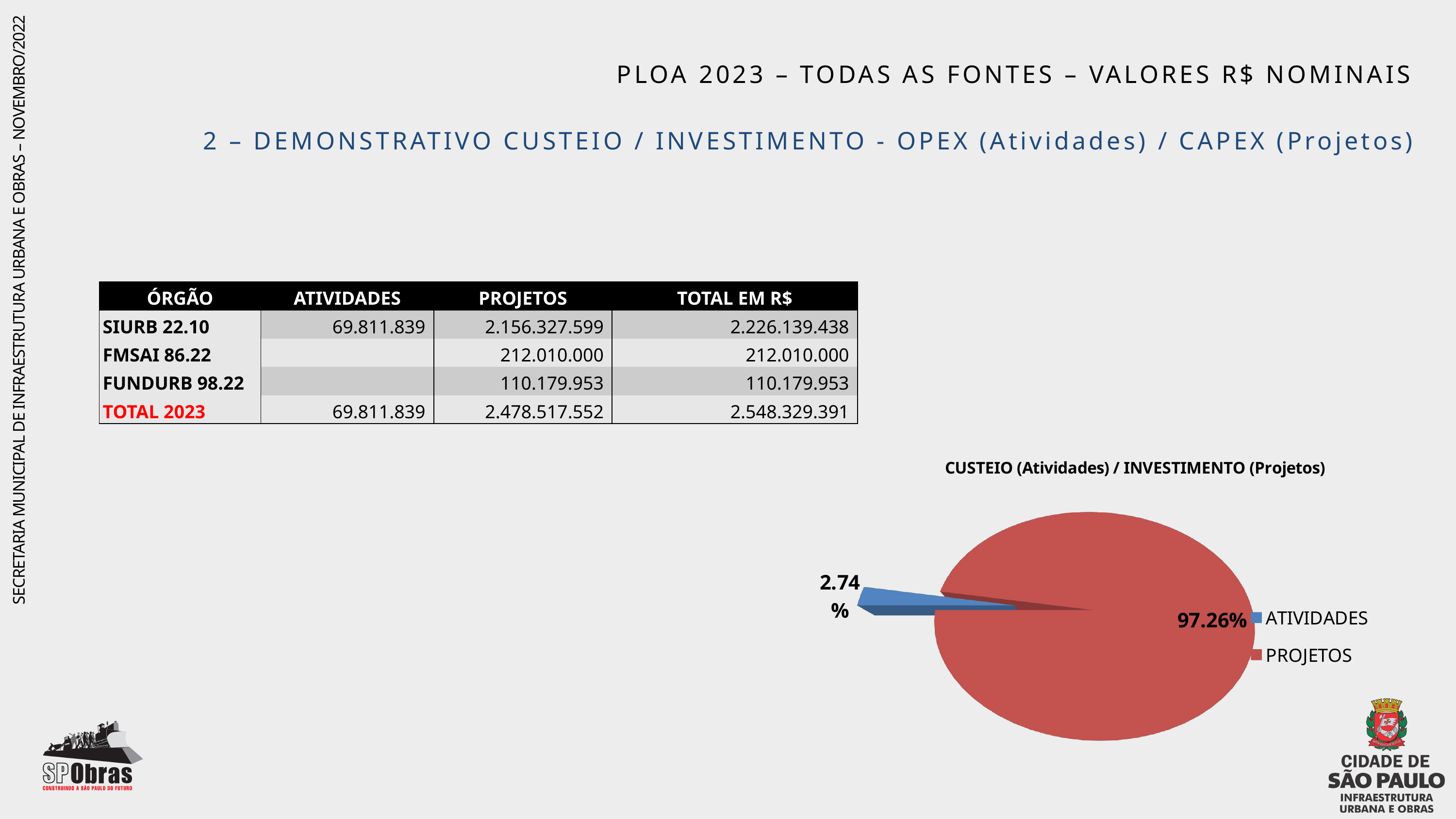
What kind of chart is shown on the slide? pie chart Which is larger in the pie chart, ATIVIDADES or PROJETOS? PROJETOS How many entries does the pie chart's legend list? 2 What colour is the PROJETOS slice in the pie chart? red What share of the pie chart does PROJETOS represent? 97.26% Which slice of the pie chart is the largest? PROJETOS How many slices does the pie chart have? 2 What share of the pie chart does ATIVIDADES represent? 2.74% Which slice of the pie chart is the smallest? ATIVIDADES What is the difference in percentage points between the PROJETOS and ATIVIDADES slices? 94.52 What is the title of the pie chart? CUSTEIO (Atividades) / INVESTIMENTO (Projetos)